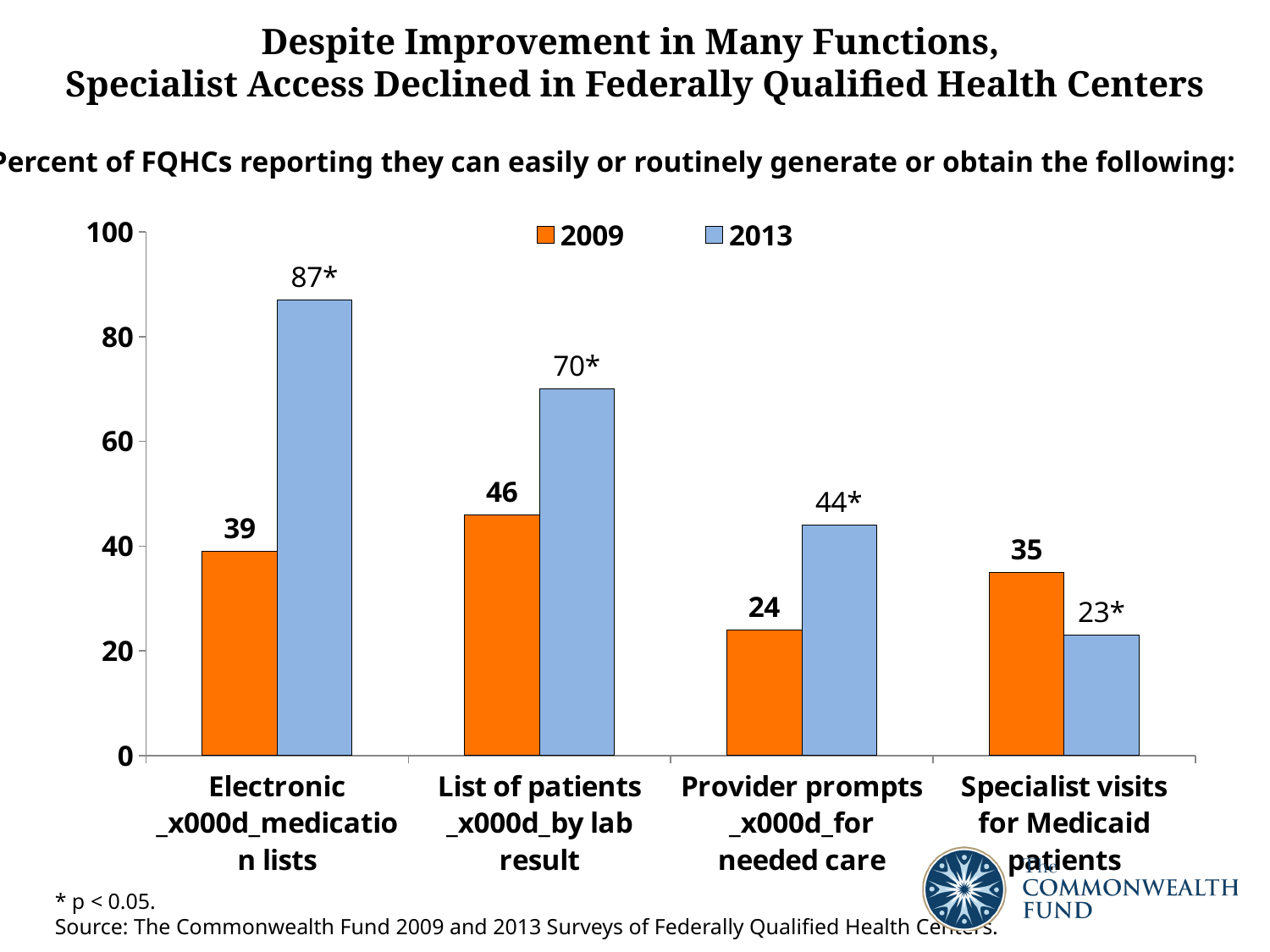
What is the difference between the 2009 and 2013 values for Specialist visits for Medicaid patients? 12 For Specialist visits for Medicaid patients, which year has the larger value, 2009 or 2013? 2009 What is the difference between the 2013 and 2009 values for Electronic medication lists? 48 What is the 2009 value for List of patients by lab result? 46 What is the 2013 value for Specialist visits for Medicaid patients? 23* Which category has the highest 2013 value? Electronic medication lists How many categories are shown on the x axis? 4 What is the 2013 value for Provider prompts for needed care? 44* How many series does the legend list? 2 Which category has the lowest 2009 value? Provider prompts for needed care What is the 2009 value for Electronic medication lists? 39 What kind of chart is shown on the slide? Bar chart